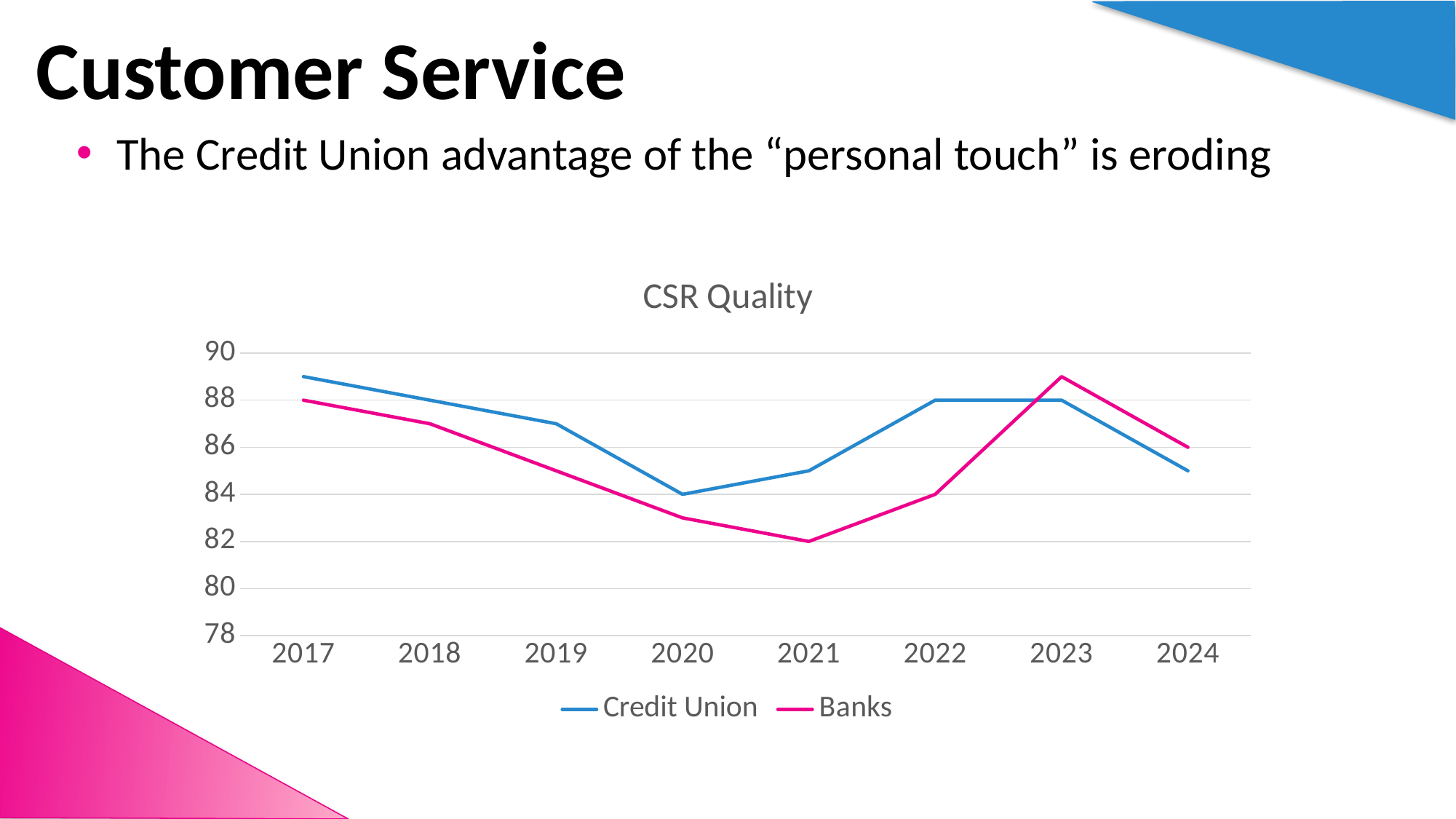
In which year is the Banks value highest? 2023 How many years are shown on the x axis? 8 What kind of chart is shown on the slide? Line chart How many series does the legend list? 2 Is the Credit Union value in 2017 greater or less than 88? greater In which year is the Banks value lowest? 2021 Which series has the higher value in 2023, Credit Union or Banks? Banks What is the Banks value in 2024? 86 What is the Banks value in 2021? 82 What is the Credit Union value in 2020? 84 What is the title of the chart? CSR Quality What is the Credit Union value in 2022? 88